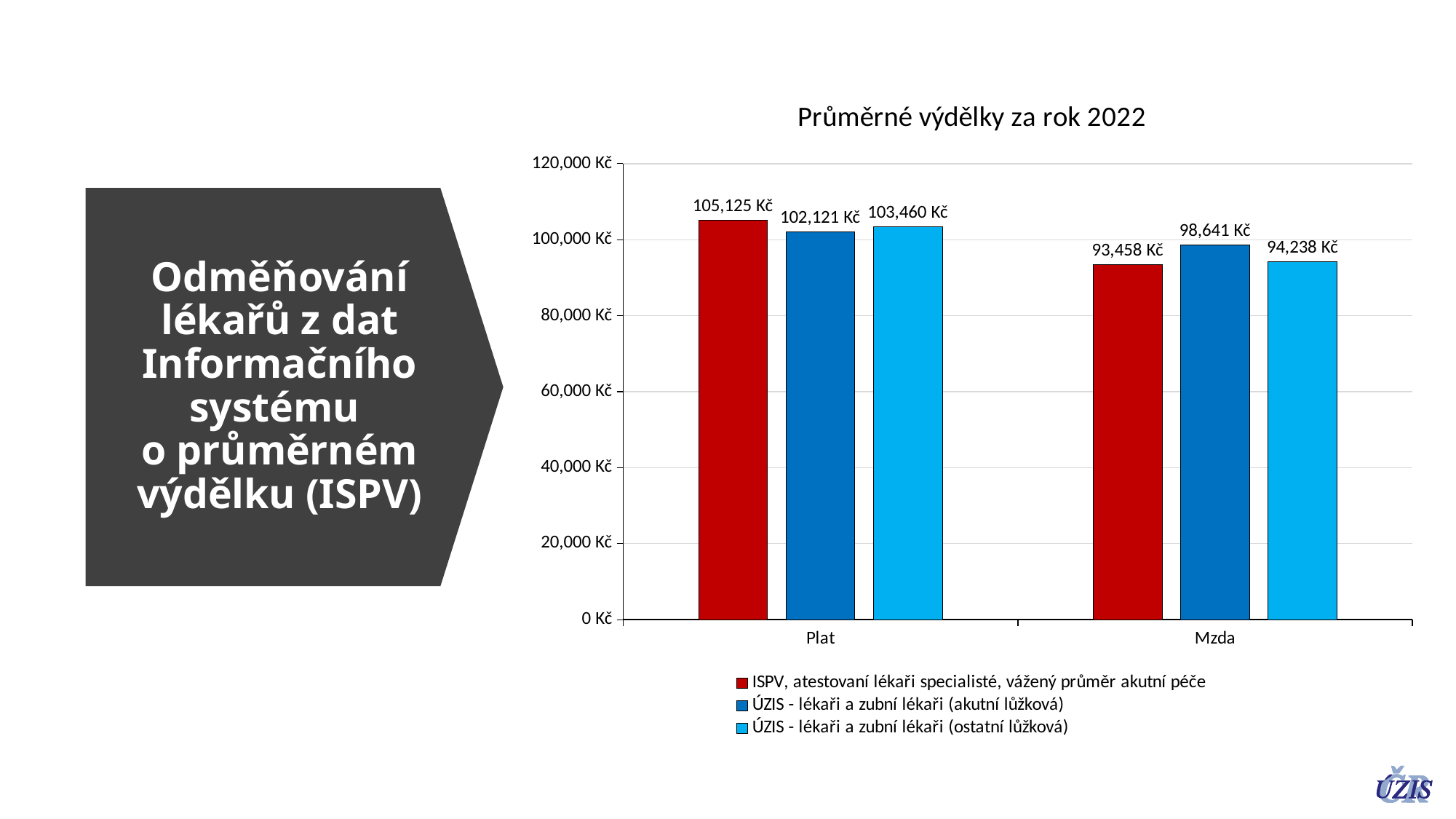
Is the value for ÚZIS (ostatní lůžková) in the Mzda category greater or less than 100,000 Kč? less How many series does the legend list? 3 What is the title of the chart? Průměrné výdělky za rok 2022 What is the difference between the ISPV values for Plat and Mzda? 11,667 Kč What is the value for ÚZIS - lékaři a zubní lékaři (ostatní lůžková) in the Plat category? 103,460 Kč Which series has the lowest value in the Mzda category? ISPV, atestovaní lékaři specialisté, vážený průměr akutní péče Which is larger: ÚZIS (ostatní lůžková) for Plat or ÚZIS (akutní lůžková) for Plat? ÚZIS (ostatní lůžková) for Plat In the Mzda category, how much higher is ÚZIS (akutní lůžková) than ISPV? 5,183 Kč What is the value for the ISPV series in the Plat category? 105,125 Kč What is the value for ÚZIS - lékaři a zubní lékaři (akutní lůžková) in the Mzda category? 98,641 Kč Which series has the highest value in the Plat category? ISPV, atestovaní lékaři specialisté, vážený průměr akutní péče What is the value for the ISPV series in the Mzda category? 93,458 Kč